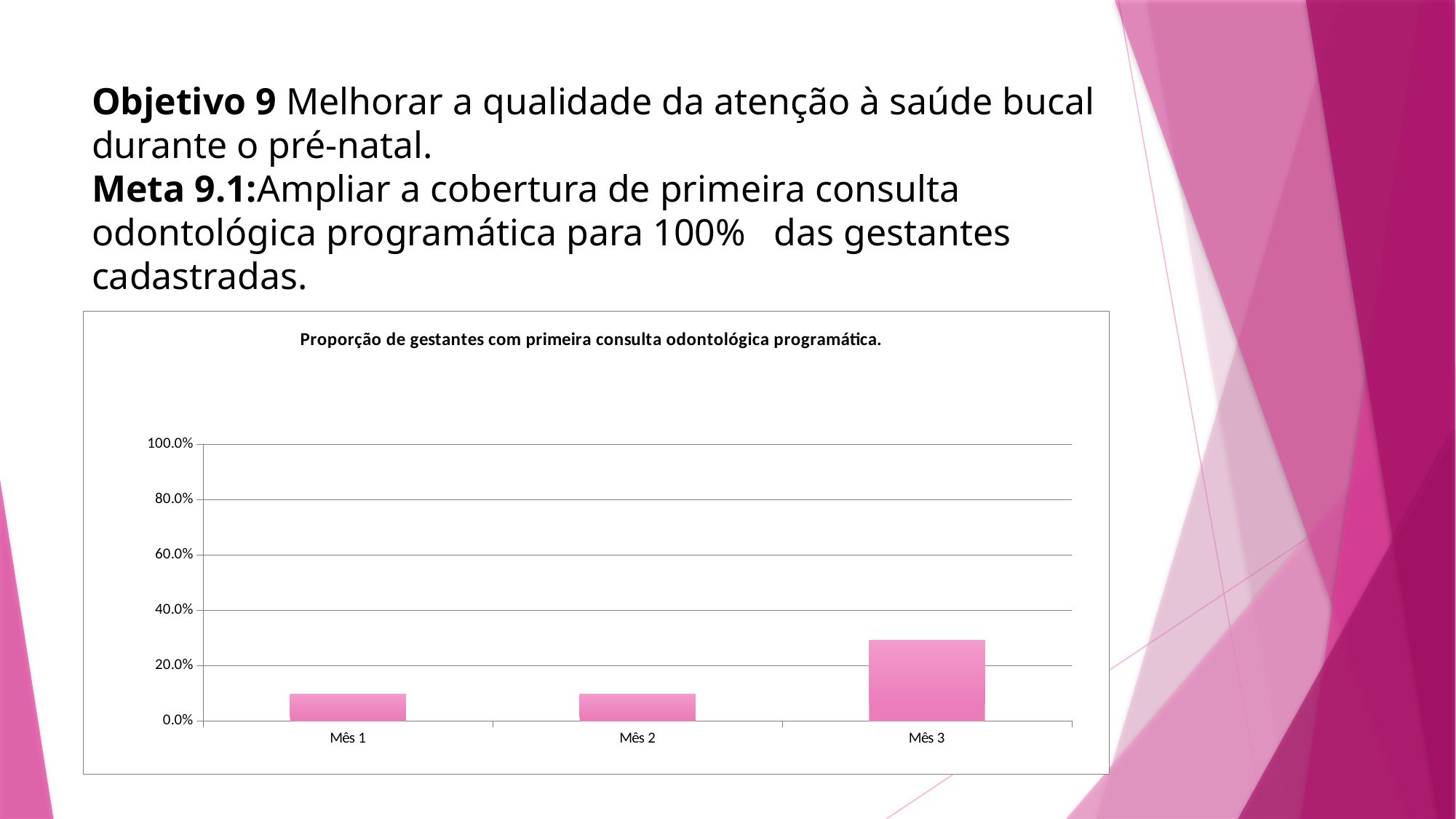
Is the value for Mês 3 greater or less than 20.0%? greater What is the highest value shown on the y axis of the chart? 100.0% What is the title of the chart? Proporção de gestantes com primeira consulta odontológica programática. What kind of chart is shown on the slide? bar chart Which is larger, the value for Mês 1 or the value for Mês 3? Mês 3 Is the value for Mês 3 greater or less than 40.0%? less Which category has the highest value in the chart? Mês 3 Is the value for Mês 1 greater or less than 20.0%? less Which is larger, the value for Mês 2 or the value for Mês 3? Mês 3 How many categories are shown on the x axis of the chart? 3